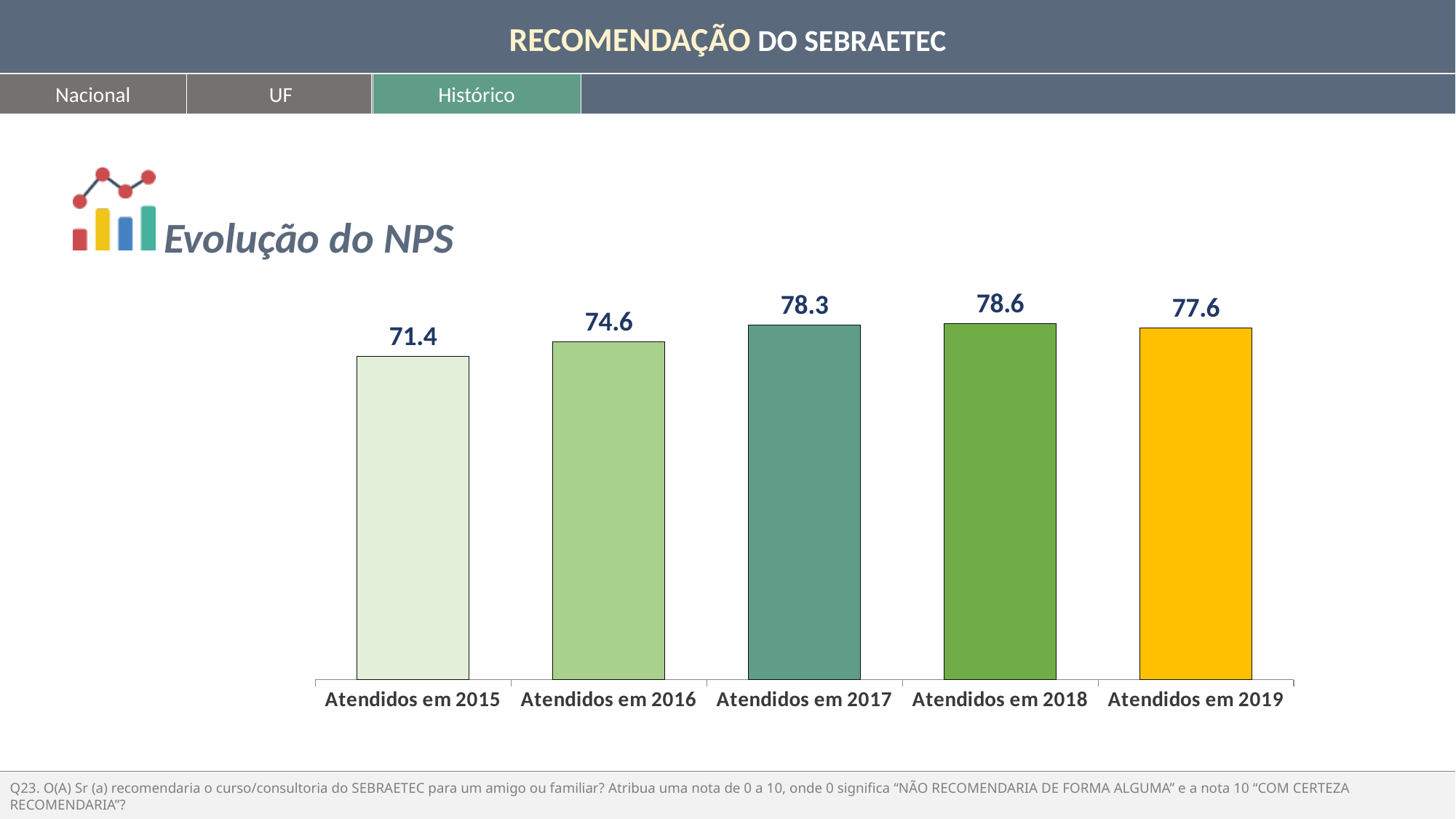
What is the NPS value for Atendidos em 2018? 78.6 What is the difference between the NPS for Atendidos em 2016 and Atendidos em 2015? 3.2 What is the NPS value for Atendidos em 2015? 71.4 Which is larger, the NPS for Atendidos em 2017 or Atendidos em 2019? Atendidos em 2017 What is the NPS value for Atendidos em 2019? 77.6 What kind of chart is shown on the slide? Bar chart What is the title of the chart? Evolução do NPS Which category has the lowest NPS value? Atendidos em 2015 How many categories are shown in the chart? 5 Does the NPS rise or fall from Atendidos em 2015 to Atendidos em 2018? Rise What is the difference between the NPS for Atendidos em 2018 and Atendidos em 2019? 1.0 Which category has the highest NPS value? Atendidos em 2018